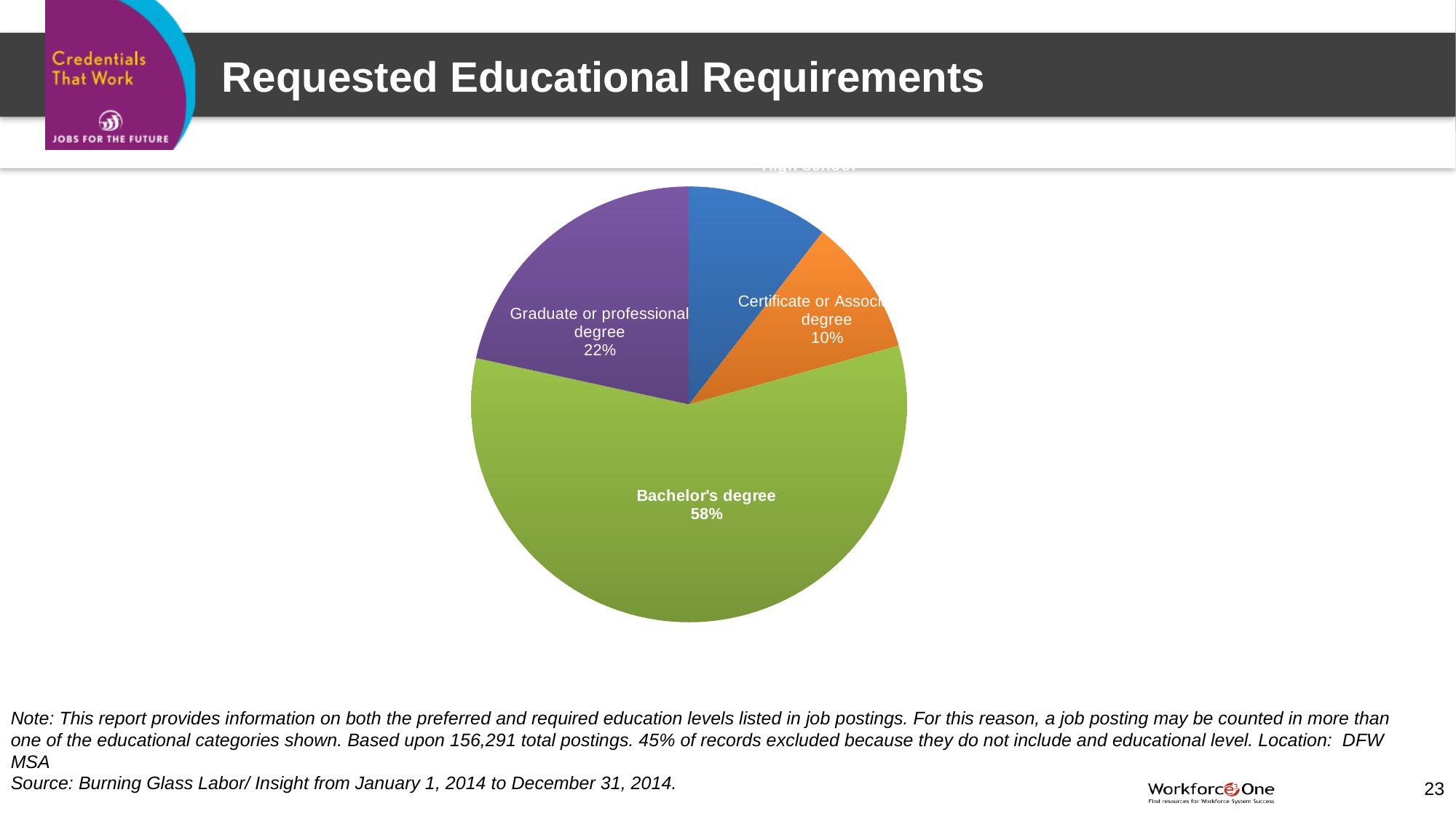
What share of the pie is labelled Bachelor's degree? 58% How many slices does the pie chart have? 4 Which slice is larger: Graduate or professional degree or Certificate or Associate degree? Graduate or professional degree What is the difference in percentage points between the Bachelor's degree slice and the Graduate or professional degree slice? 36 percentage points Is the Bachelor's degree share greater or less than 50%? greater What kind of chart is shown on the slide? pie chart What share of the pie is labelled Graduate or professional degree? 22% Which educational category has the largest slice of the pie? Bachelor's degree What percentage is shown for the Certificate or Associate degree slice? 10% What is the title of the slide containing the pie chart? Requested Educational Requirements What is the combined share of the Graduate or professional degree and Certificate or Associate degree slices? 32% What colour is the Bachelor's degree slice? green